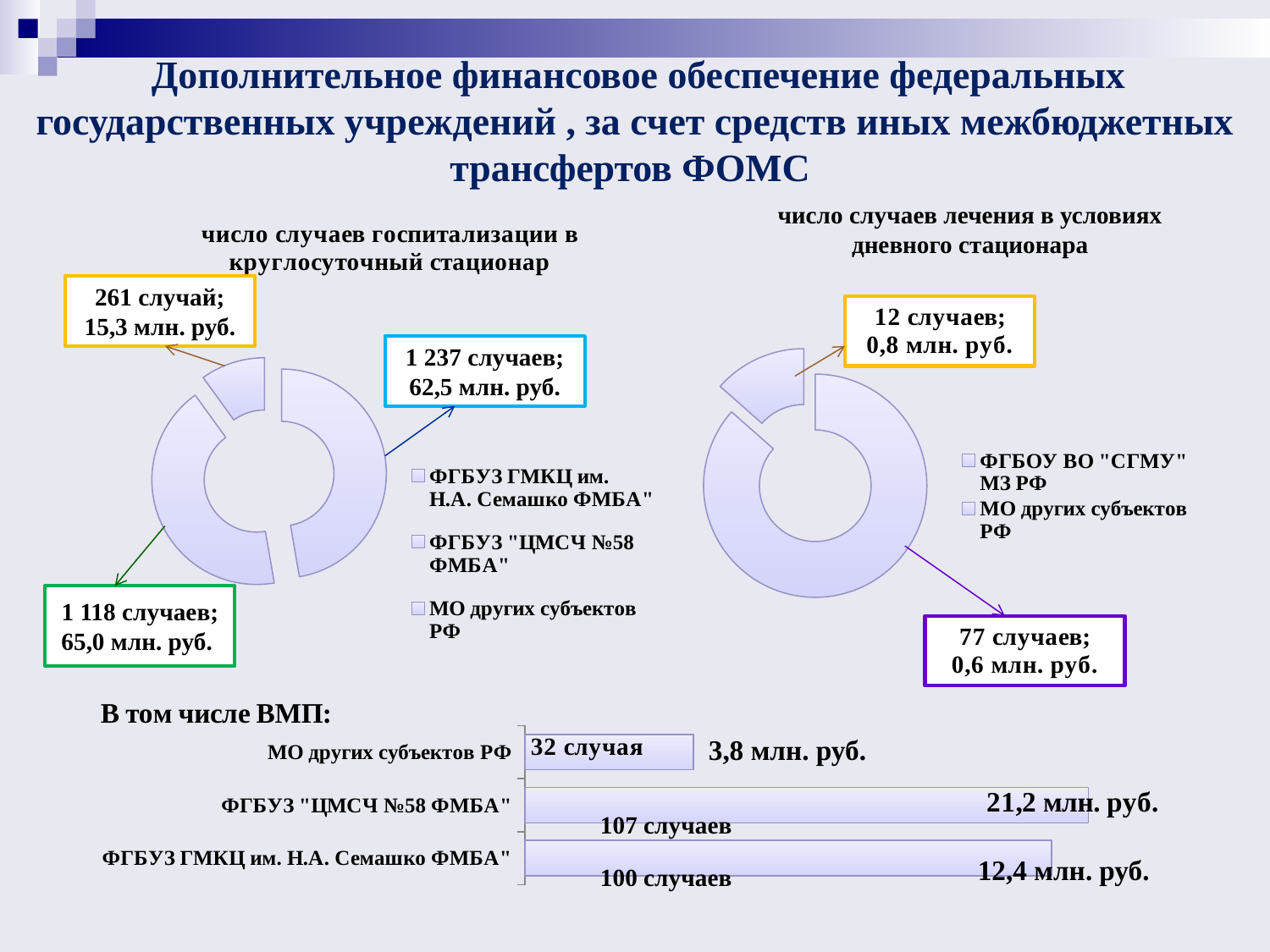
In the right doughnut chart (число случаев лечения в условиях дневного стационара), how many cases are in the callout that shows 0,6 млн. руб.? 77 случаев In the bar chart at the bottom (В том числе ВМП), which category has the lowest number of cases? МО других субъектов РФ How many entries does the legend of the left doughnut chart (число случаев госпитализации в круглосуточный стационар) list? 3 In the bar chart at the bottom (В том числе ВМП), which category has the highest number of cases? ФГБУЗ "ЦМСЧ №58 ФМБА" In the bar chart at the bottom (В том числе ВМП), what is the difference in the number of cases between ФГБУЗ "ЦМСЧ №58 ФМБА" and ФГБУЗ ГМКЦ им. Н.А. Семашко ФМБА"? 7 In the bar chart at the bottom (В том числе ВМП), what amount in млн. руб. is shown for ФГБУЗ ГМКЦ им. Н.А. Семашко ФМБА"? 12,4 млн. руб. How many categories are shown in the bar chart at the bottom (В том числе ВМП)? 3 In the bar chart at the bottom (В том числе ВМП), how many cases are shown for ФГБУЗ "ЦМСЧ №58 ФМБА"? 107 случаев In the left doughnut chart (число случаев госпитализации в круглосуточный стационар), what is the total number of cases across the three callouts? 2 616 In the bar chart at the bottom (В том числе ВМП), which has the larger amount in млн. руб.: ФГБУЗ "ЦМСЧ №58 ФМБА" or ФГБУЗ ГМКЦ им. Н.А. Семашко ФМБА"? ФГБУЗ "ЦМСЧ №58 ФМБА" What kind of chart is the chart at the bottom of the slide (В том числе ВМП)? bar chart In the bar chart at the bottom (В том числе ВМП), how many cases are shown for МО других субъектов РФ? 32 случая